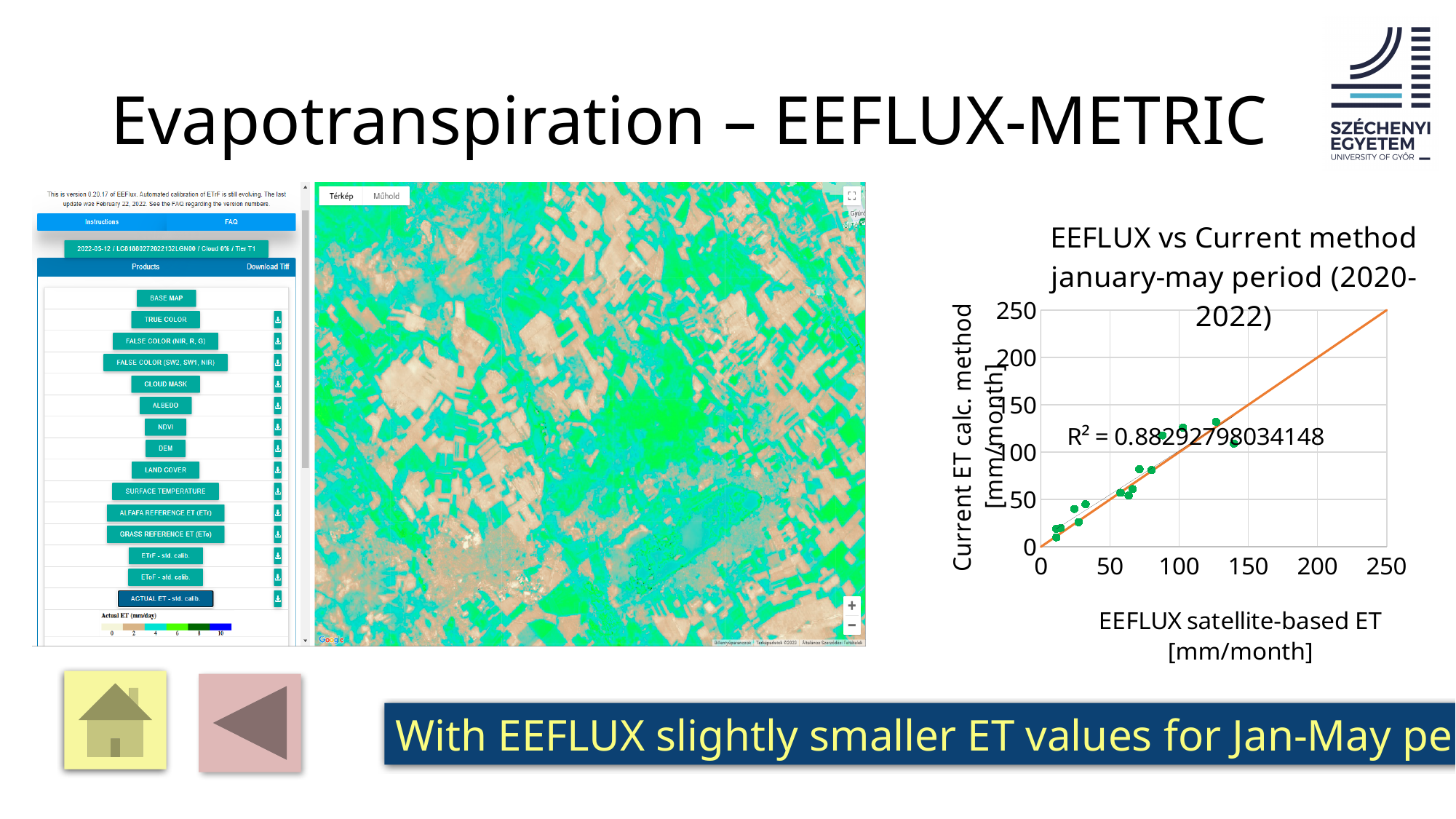
What is the highest tick value shown on the y axis of the scatter chart? 250 Are all plotted points on the scatter chart below 200 on the x axis? yes What R² value is printed on the scatter chart? R² = 0.88292798034148 What is the title of the chart on the right side of the slide? EEFLUX vs Current method january-may period (2020-2022) What kind of chart is shown on the right side of the slide? scatter chart What is the label of the x axis of the scatter chart? EEFLUX satellite-based ET [mm/month] Do the points on the scatter chart rise or fall as the EEFLUX satellite-based ET increases? rise What is the highest tick value shown on the x axis of the scatter chart? 250 Is the highest plotted point on the scatter chart greater or less than 150 mm/month on the y axis? less Is the R² value shown on the scatter chart greater or less than 0.8? greater